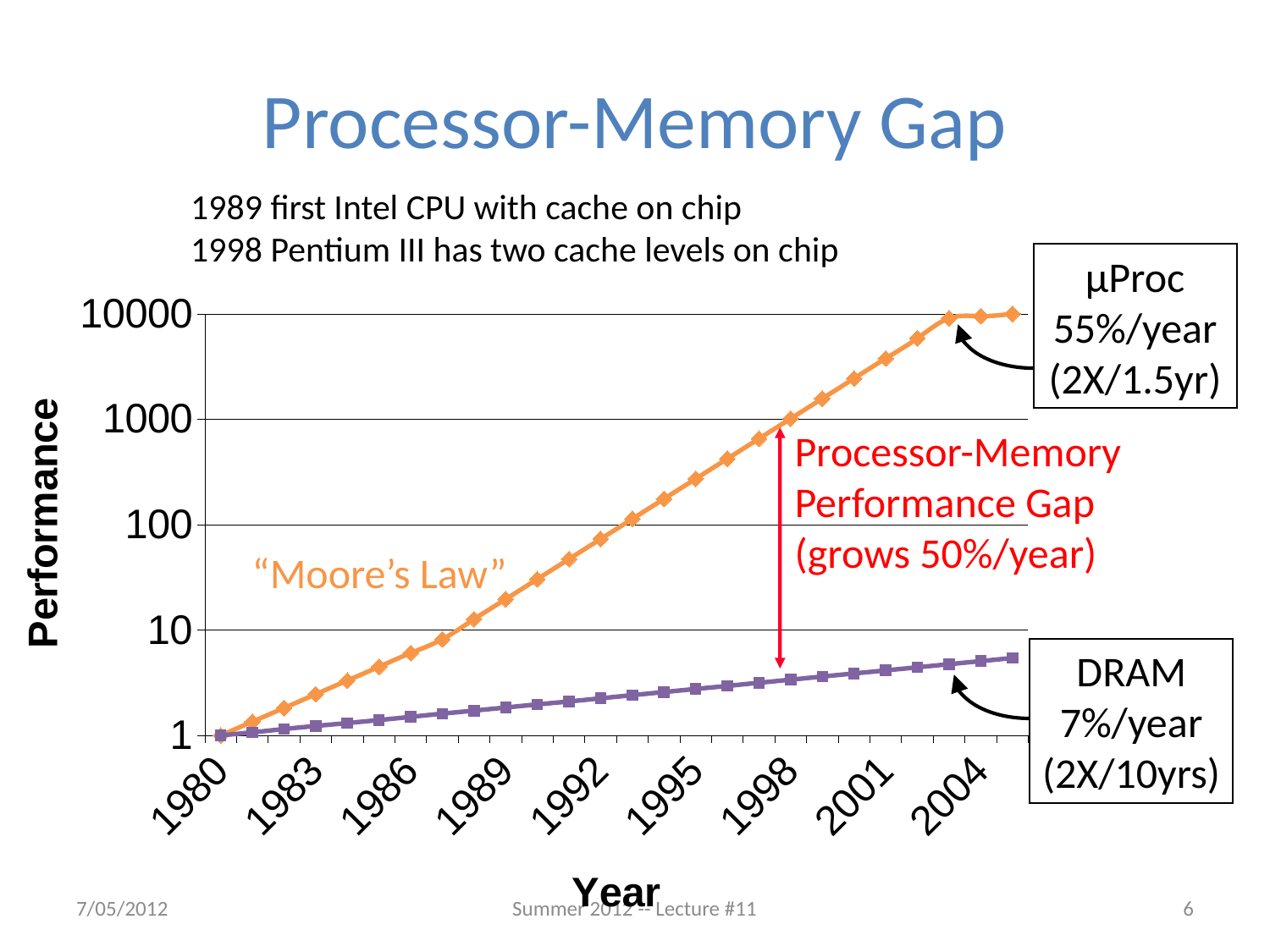
Is the µProc performance value in 1989 greater or less than 100? less What kind of chart is shown on the slide? line chart Is the µProc performance value in 2004 greater or less than 1000? greater What is the label of the y axis? Performance Does the DRAM series rise or fall from 1980 to 2004? rise Which series has the higher performance value in 2004, µProc or DRAM? µProc Is the DRAM performance value in 1992 greater or less than 10? less Does the µProc series rise or fall from 1980 to 2004? rise How many data series are plotted on the chart? 2 What is the title of the chart on the slide? Processor-Memory Gap